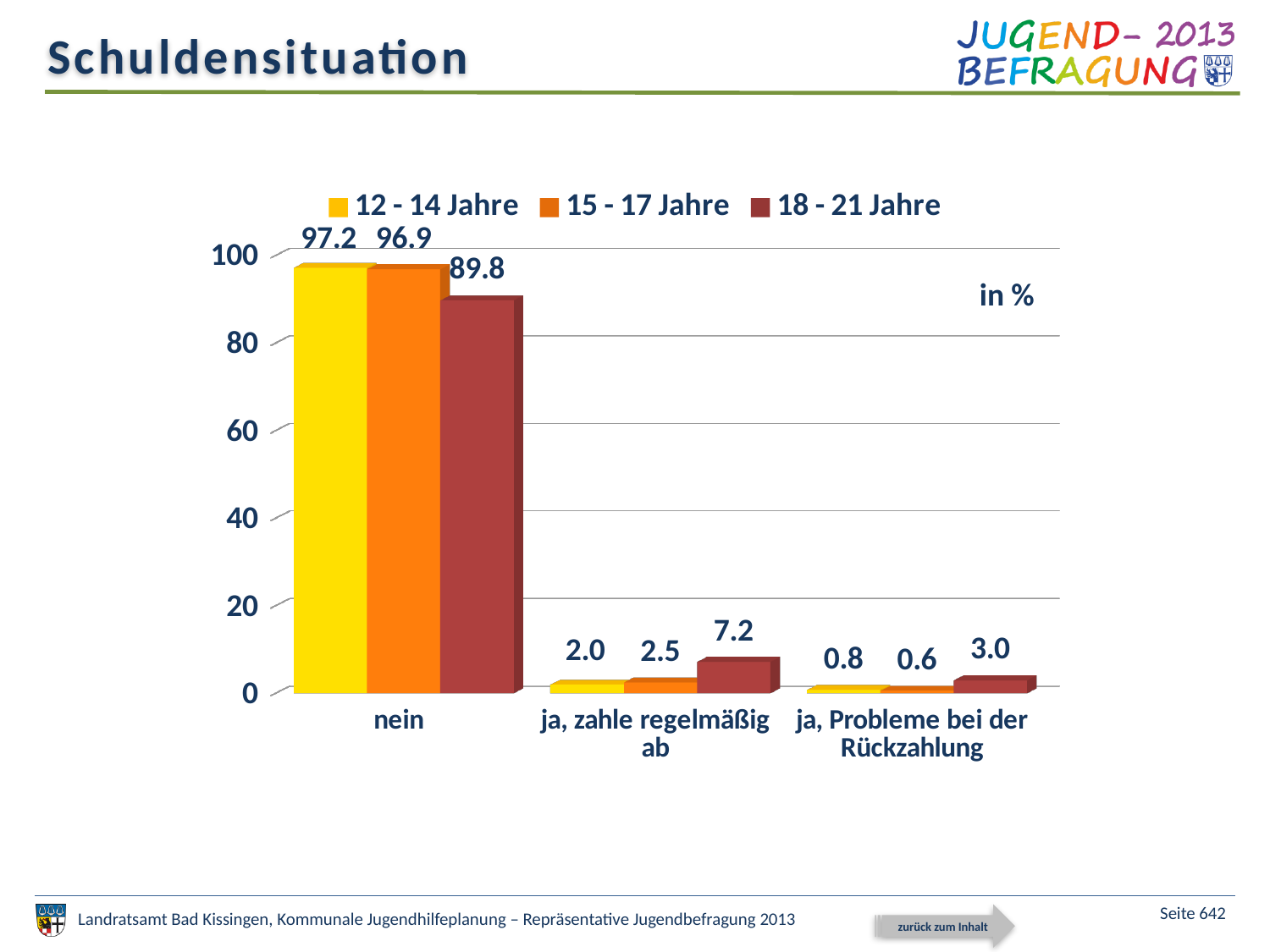
What is the value for '12 - 14 Jahre' in the 'nein' category? 97.2 How many categories are shown on the x axis? 3 What is the difference between the '12 - 14 Jahre' and '18 - 21 Jahre' values in the 'nein' category? 7.4 How many series does the legend list? 3 Which is larger in the 'ja, zahle regelmäßig ab' category: the value for '12 - 14 Jahre' or for '18 - 21 Jahre'? 18 - 21 Jahre Which age group has the lowest value in the 'nein' category? 18 - 21 Jahre Which age group has the highest value in the 'ja, Probleme bei der Rückzahlung' category? 18 - 21 Jahre Is the value for '18 - 21 Jahre' in the 'nein' category greater or less than 80? greater What unit is indicated for the values in the chart? in % What is the value for '15 - 17 Jahre' in the 'ja, Probleme bei der Rückzahlung' category? 0.6 What kind of chart is shown on the slide? bar chart What is the value for '18 - 21 Jahre' in the 'ja, zahle regelmäßig ab' category? 7.2